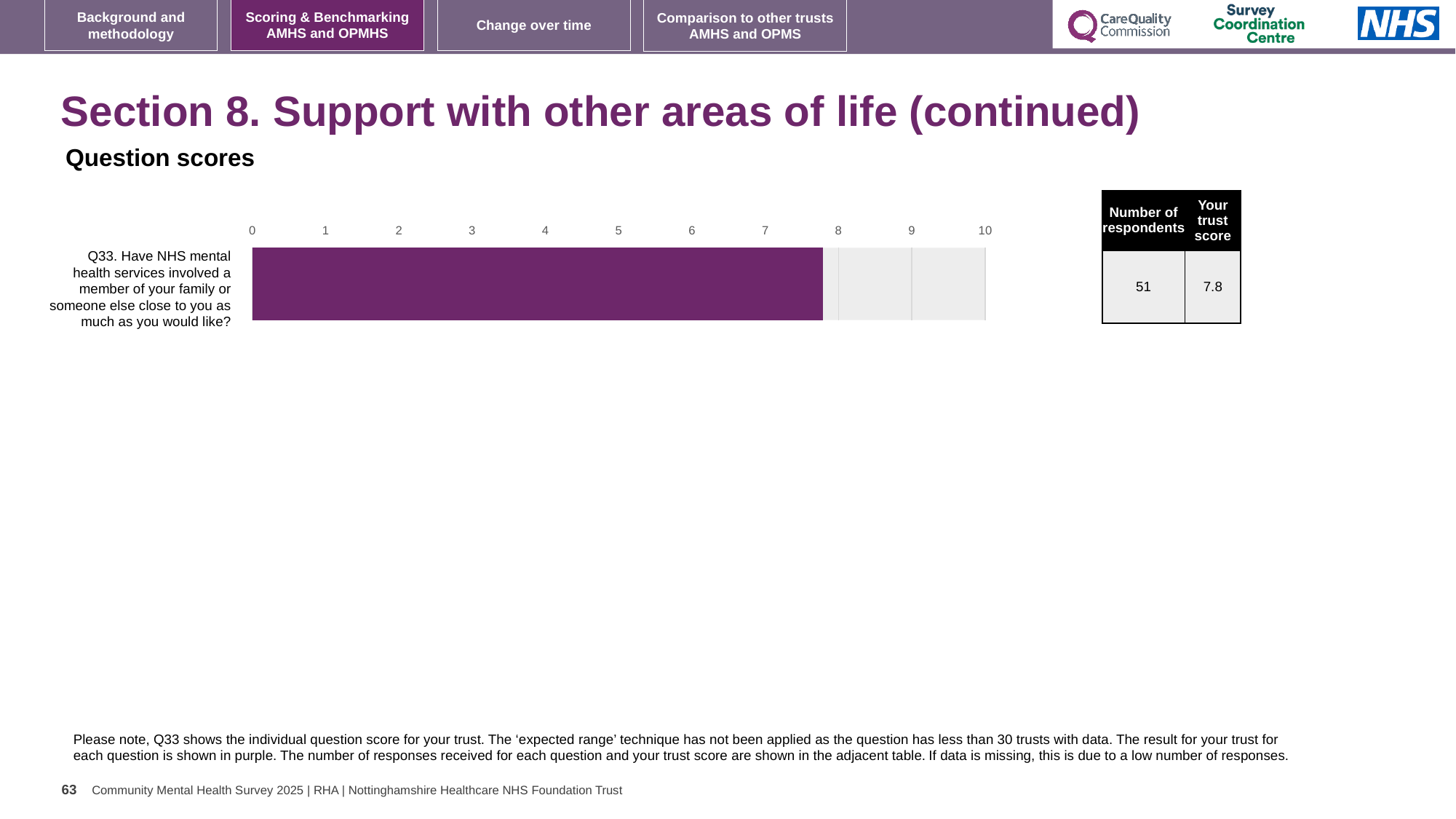
How many respondents answered Q33 according to the table? 51 How many questions (categories) are plotted in the chart? 1 What colour is the bar for Q33? Purple What is the maximum value shown on the chart's axis? 10 What kind of chart is shown on the slide? Bar chart What is the trust score for Q33 shown in the table next to the chart? 7.8 Is the value of the bar for Q33 greater or less than 5? greater Is the value of the bar for Q33 greater or less than 7? greater